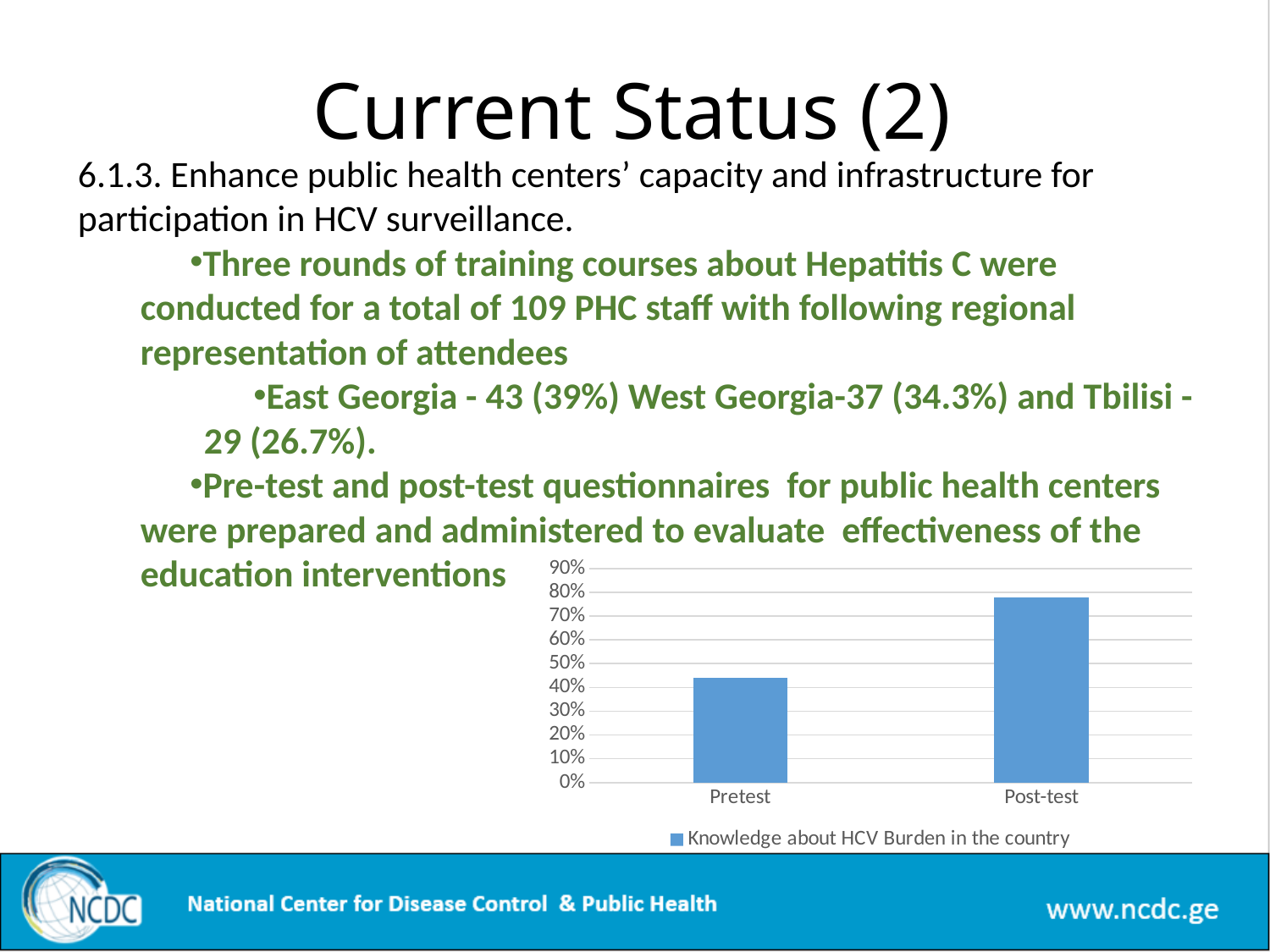
Is the value for Post-test greater or less than 70%? greater How many categories are plotted on the x axis of the chart? 2 Is the value for Pretest greater or less than 50%? less Which category has the lowest value in the chart? Pretest How many series does the chart legend list? 1 Which is larger, the value for Pretest or the value for Post-test? Post-test What kind of chart is shown on the slide? bar chart Which category has the highest value in the chart? Post-test Do the values rise or fall from Pretest to Post-test? rise Is the value for Post-test greater or less than 80%? less What series name is shown in the chart legend? Knowledge about HCV Burden in the country